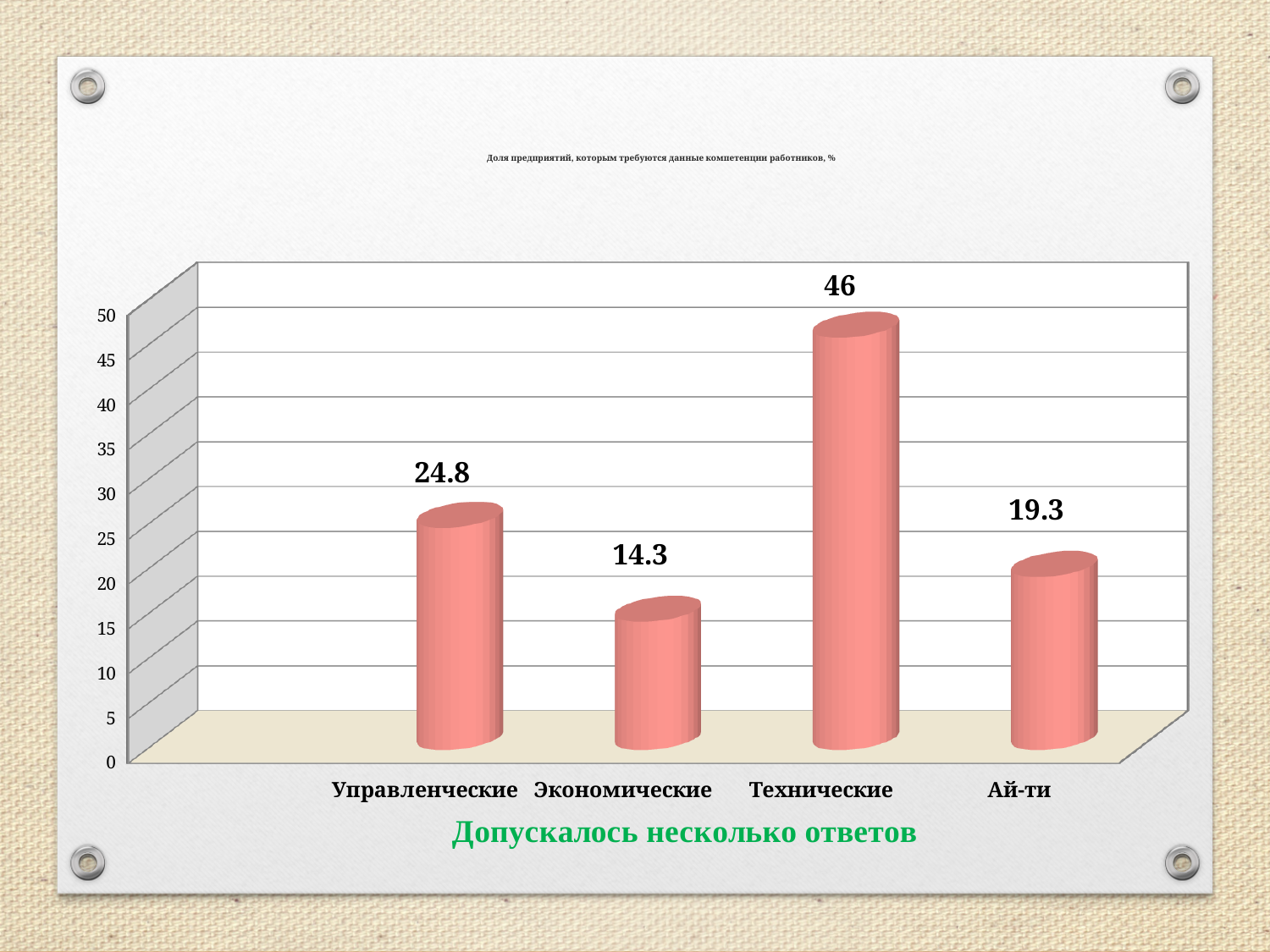
What note is written in green below the chart? Допускалось несколько ответов What is the value for Ай-ти? 19.3 How many categories are shown on the chart? 4 What is the value for Технические? 46 Which category has the lowest value? Экономические Which category has the highest value? Технические What is the difference between the values for Технические and Управленческие? 21.2 What is the value for Управленческие? 24.8 What is the difference between the values for Ай-ти and Экономические? 5 What kind of chart is shown on the slide? Bar chart What is the value for Экономические? 14.3 Which is larger, the value for Управленческие or the value for Ай-ти? Управленческие